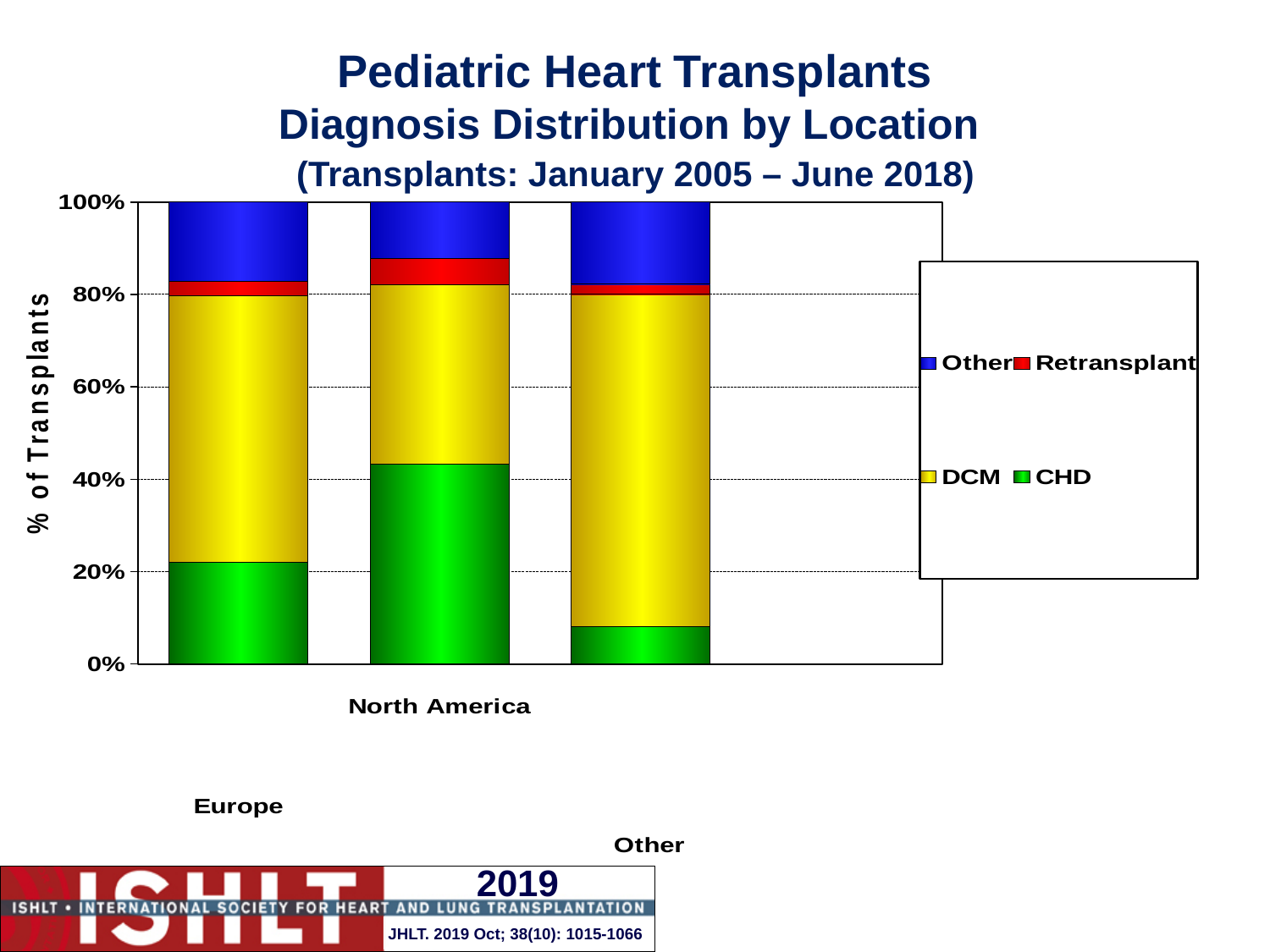
Is the CHD share for Europe greater or less than 40%? less What is the label on the y axis? % of Transplants How many location categories are shown on the x axis? 3 How many series does the legend list? 4 Which series is shown in yellow in the legend? DCM What kind of chart is shown on the slide? Stacked bar chart Which location has the smallest CHD share? Other Which has a larger CHD share, Europe or North America? North America Is the CHD share for Other greater or less than 20%? less What is the total of the stacked bar for Europe? 100% Which location has the largest CHD share? North America Is the CHD share for North America greater or less than 40%? greater